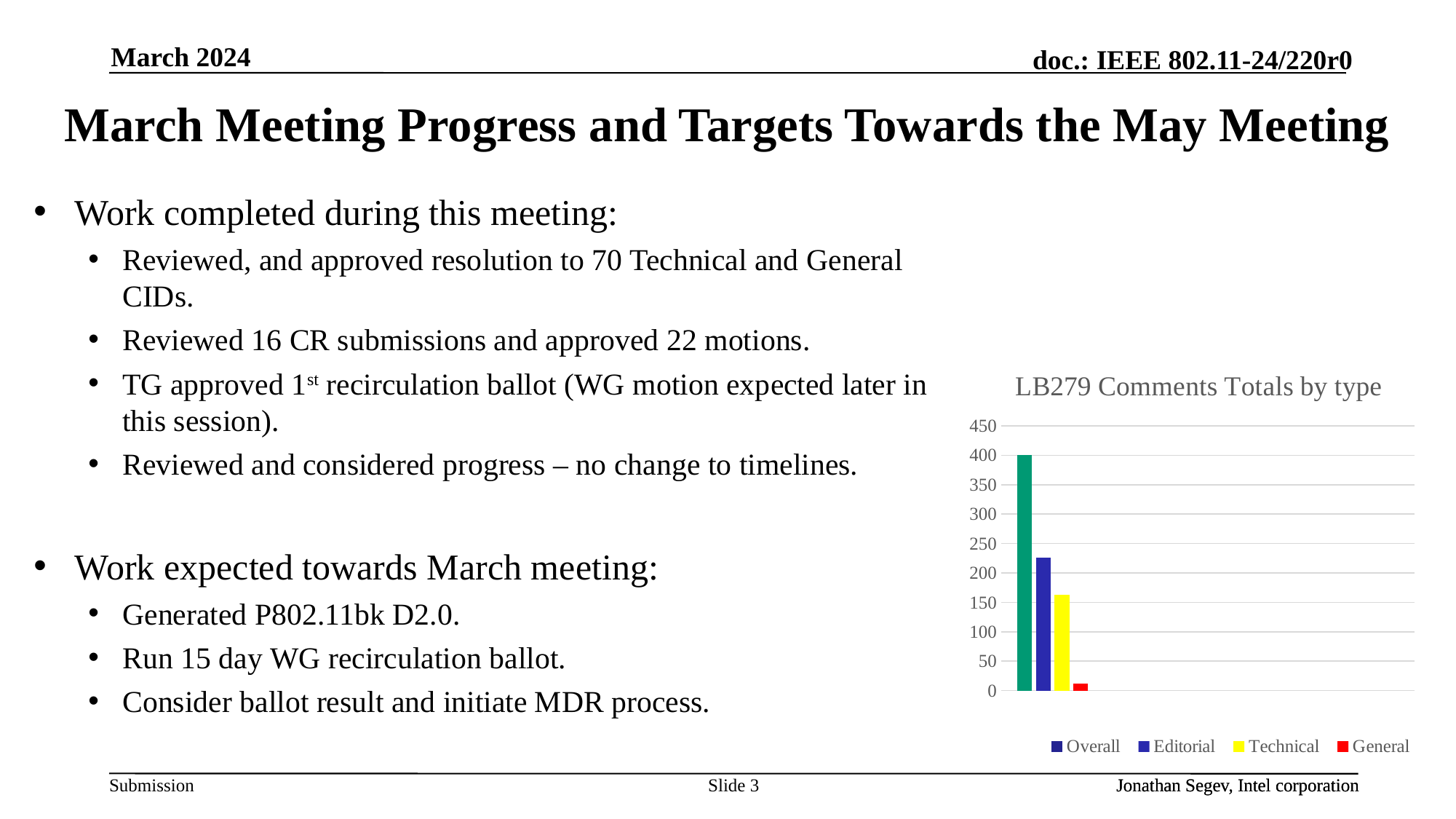
Which is larger, the value for Technical or the value for General? Technical Is the value for Overall greater or less than 350? greater What is the title of the chart? LB279 Comments Totals by type Is the value for General greater or less than 50? less Which series has the lowest value in the chart? General Is the value for Editorial greater or less than 200? greater What colour is the Technical bar in the chart? yellow Which is larger, the value for Editorial or the value for Technical? Editorial How many series does the chart legend list? 4 What type of chart is shown on the slide? bar chart Which series has the highest value in the chart? Overall